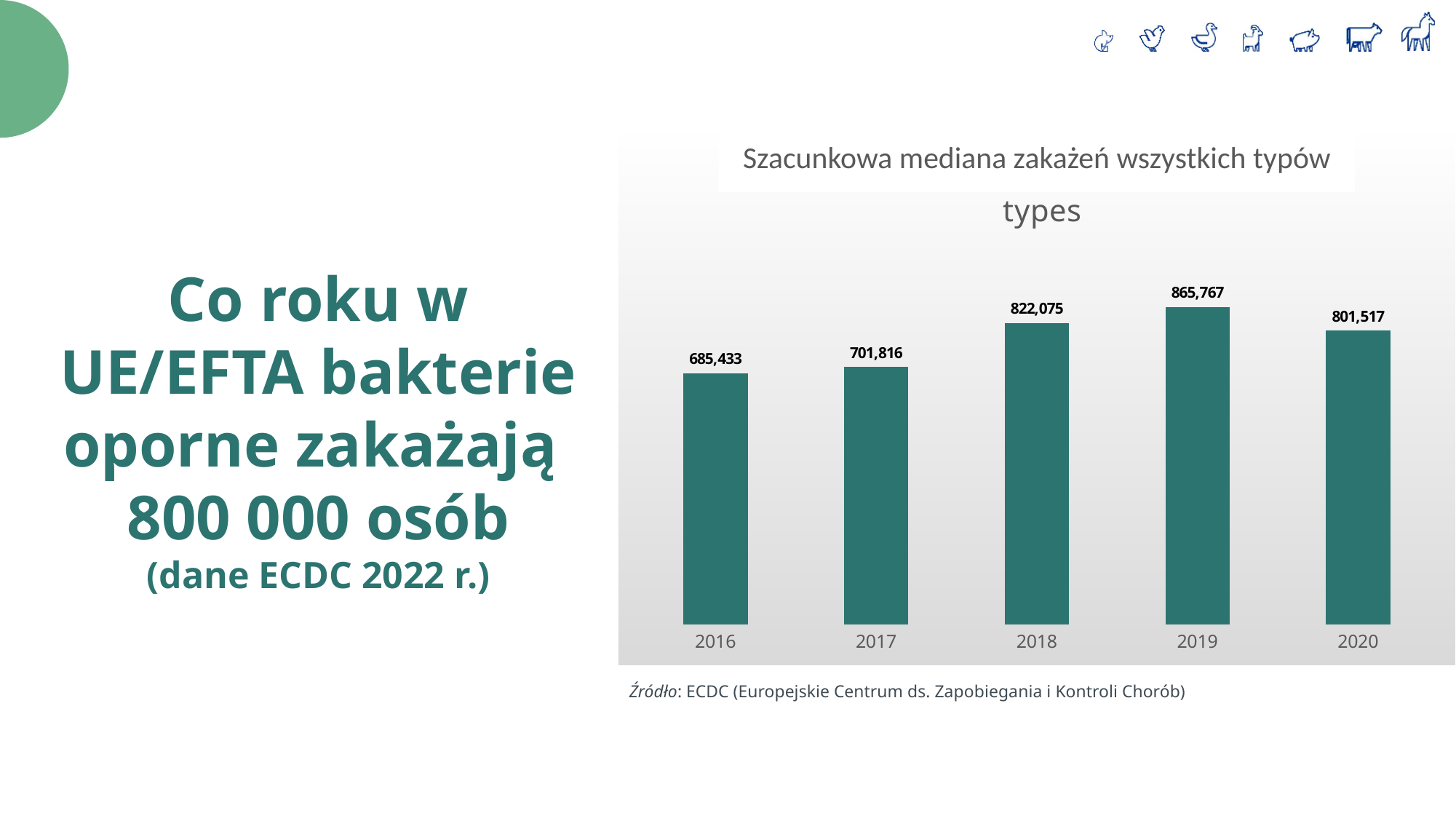
What is the value for 2018? 822,075 Which year has the highest value? 2019 Which year has the lowest value? 2016 What is the value for 2020? 801,517 What is the source cited below the chart? ECDC (Europejskie Centrum ds. Zapobiegania i Kontroli Chorób) How many years are shown on the x axis? 5 What is the difference between the values for 2017 and 2016? 16,383 What is the value for 2016? 685,433 What is the difference between the values for 2019 and 2018? 43,692 What kind of chart is shown? Bar chart Which is larger, the value for 2018 or the value for 2020? 2018 Do the values rise or fall from 2016 to 2019? Rise